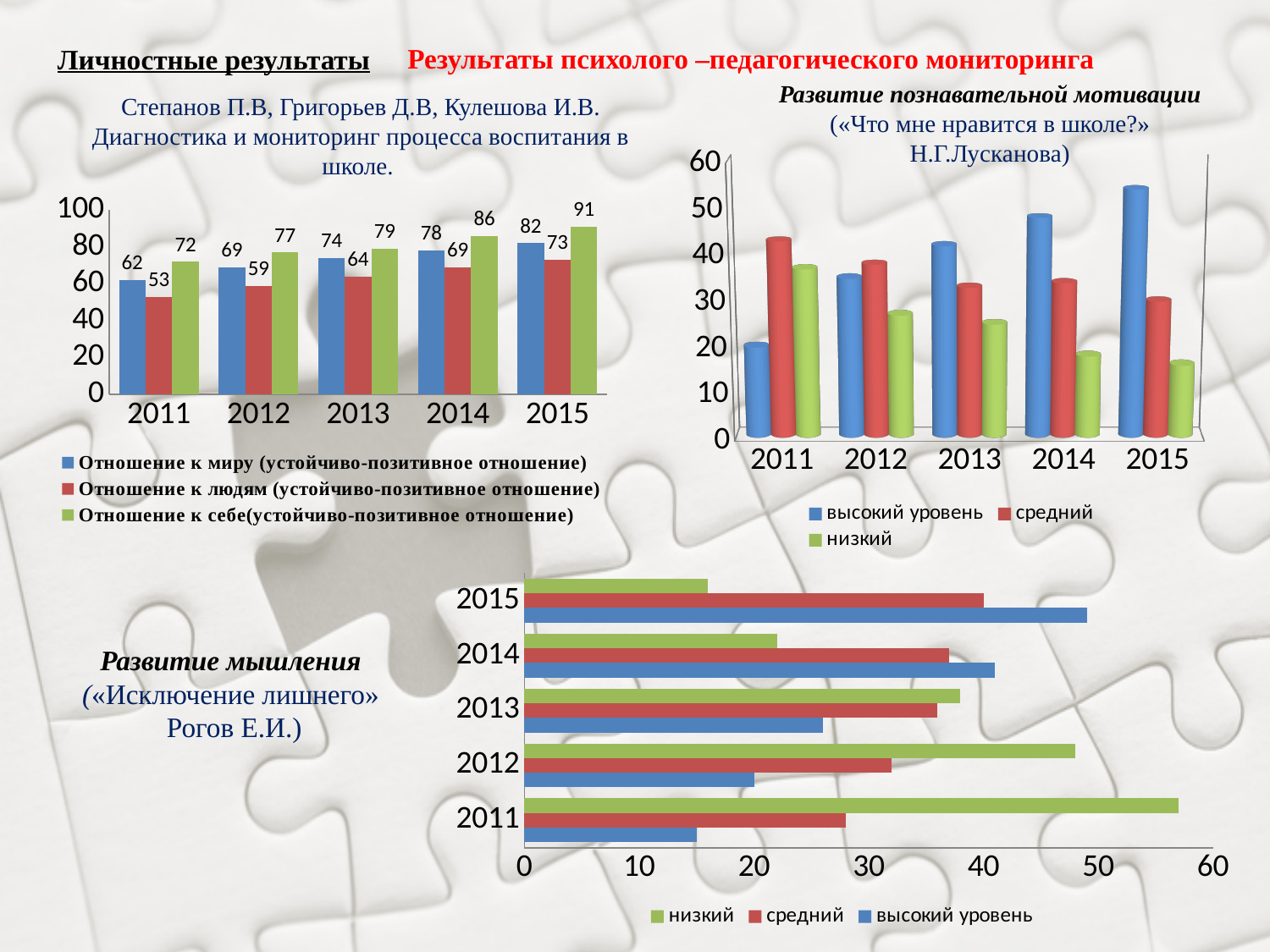
In the top-left chart (Диагностика и мониторинг процесса воспитания в школе), what is the value for 'Отношение к себе' in 2015? 91 In the top-right chart (Развитие познавательной мотивации), is the value for 'низкий' in 2011 greater or less than 30? greater In the top-right chart (Развитие познавательной мотивации), in which year is 'высокий уровень' highest? 2015 In the top-left chart (Диагностика и мониторинг процесса воспитания в школе), does 'Отношение к миру' rise or fall from 2011 to 2015? rises In the top-left chart (Диагностика и мониторинг процесса воспитания в школе), what is the difference between 'Отношение к себе' and 'Отношение к миру' in 2015? 9 In the top-right chart (Развитие познавательной мотивации), is the value for 'высокий уровень' in 2015 greater or less than 50? greater In the top-left chart (Диагностика и мониторинг процесса воспитания в школе), in which year is 'Отношение к миру' highest? 2015 In the bottom chart (Развитие мышления), which is larger in 2011: 'низкий' or 'высокий уровень'? низкий In the top-left chart (Диагностика и мониторинг процесса воспитания в школе), how many series does the legend list? 3 In the top-left chart (Диагностика и мониторинг процесса воспитания в школе), what is the value for 'Отношение к людям' in 2011? 53 In the top-left chart (Диагностика и мониторинг процесса воспитания в школе), how many years are shown on the x axis? 5 What kind of chart is the bottom chart (Развитие мышления)? bar chart